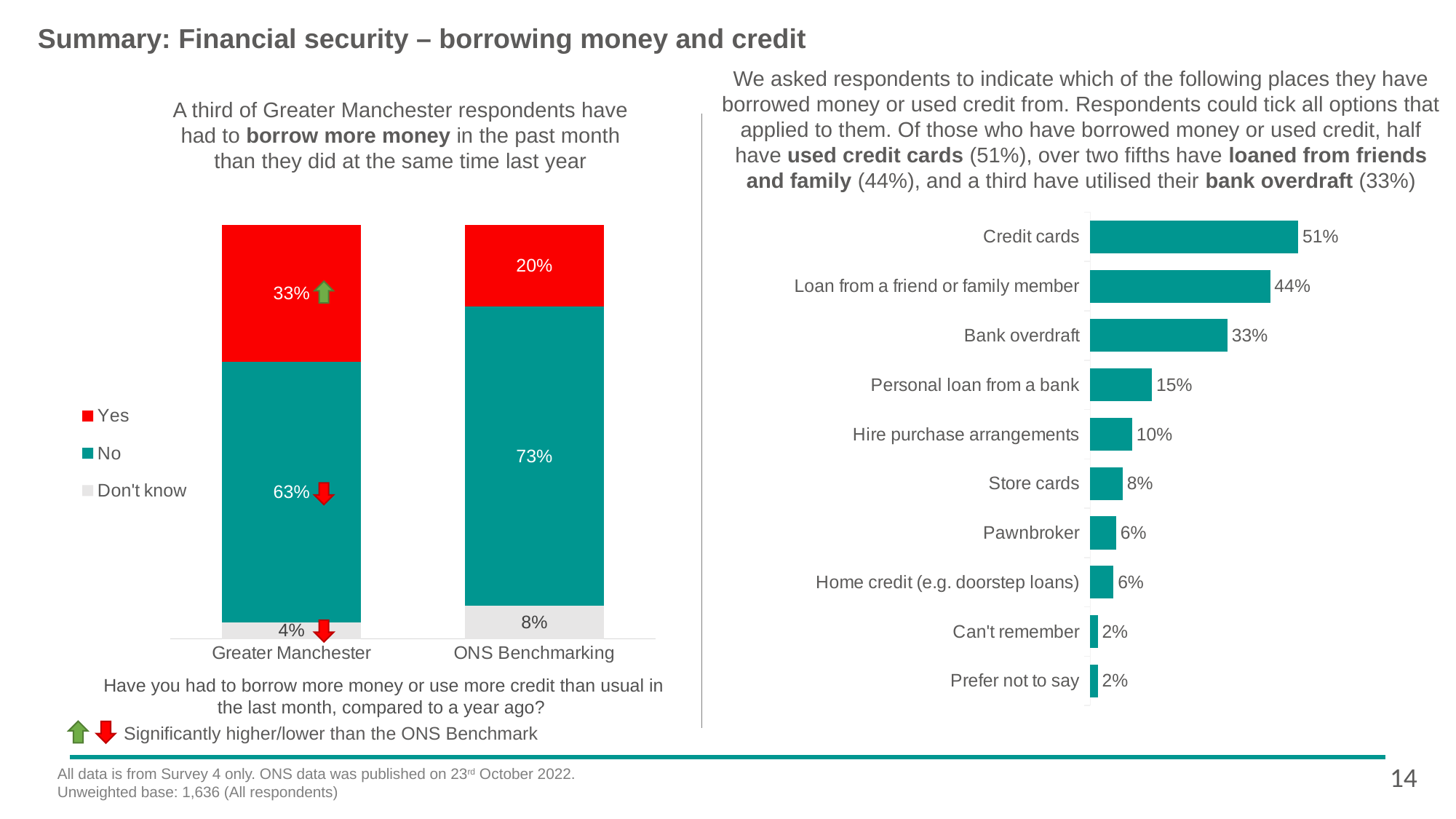
In the left stacked bar chart, what is the total of the three segments for the Greater Manchester bar? 100% In the right-hand bar chart, what percentage of respondents used a bank overdraft? 33% In the right-hand bar chart, how many categories are shown? 10 In the right-hand bar chart, which is larger, 'Personal loan from a bank' or 'Hire purchase arrangements'? Personal loan from a bank In the left stacked bar chart, which group has the larger 'Don't know' share, Greater Manchester or ONS Benchmarking? ONS Benchmarking How many series does the legend of the left stacked bar chart list? 3 In the left stacked bar chart, what percentage of ONS Benchmarking respondents answered 'No'? 73% In the right-hand bar chart, which category has the highest value? Credit cards What type of chart is the right-hand chart? Bar chart In the left stacked bar chart, what percentage of Greater Manchester respondents answered 'Yes'? 33% In the left stacked bar chart, what is the difference between the 'Yes' share for Greater Manchester and for ONS Benchmarking? 13 percentage points In the right-hand bar chart, what is the difference between 'Credit cards' and 'Loan from a friend or family member'? 7 percentage points